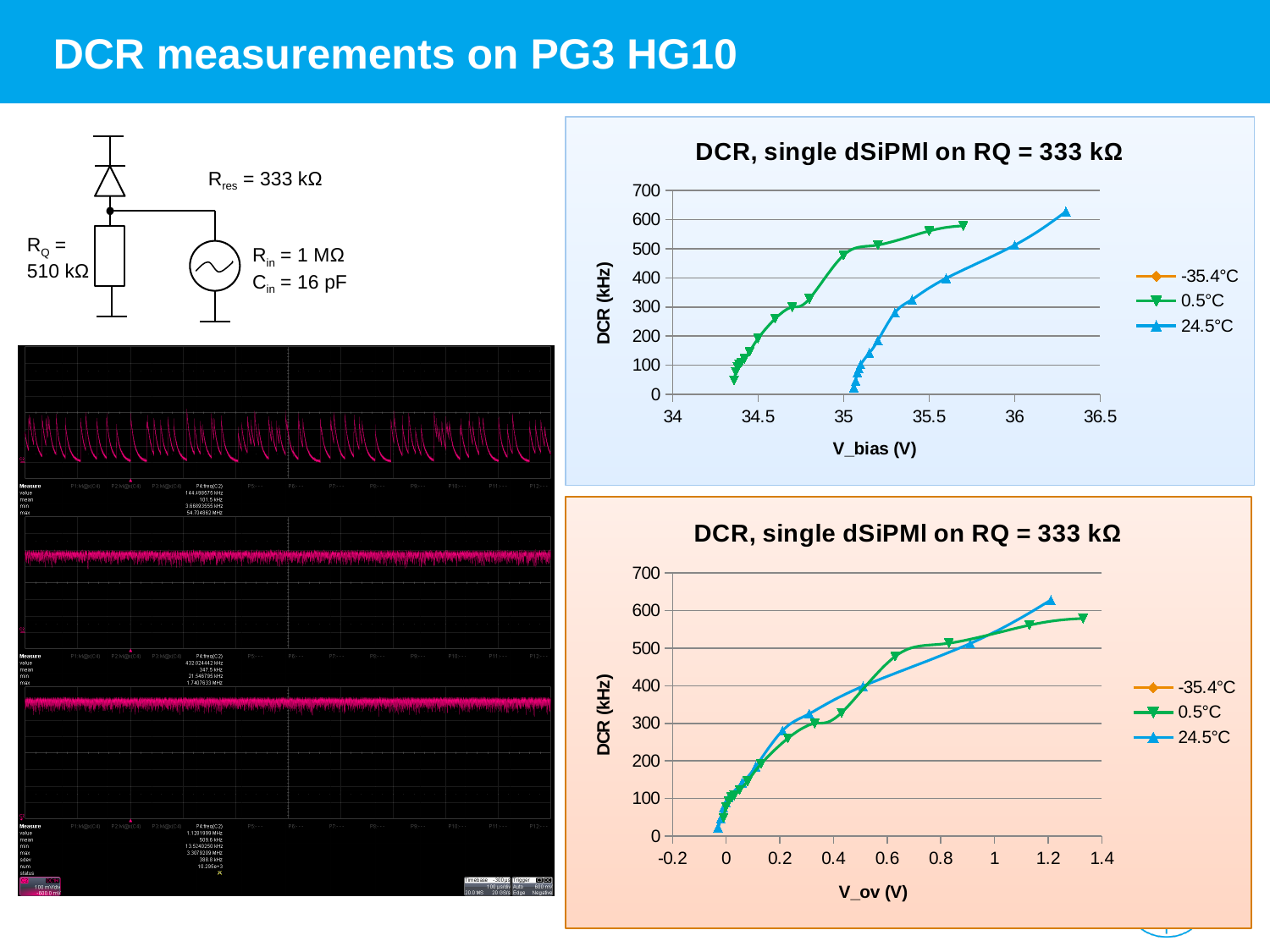
In the bottom-right chart, is the DCR for the 0.5°C series at V_ov = 0.2 V greater or less than 300 kHz? less How many series does the legend of the bottom-right chart list? 3 In the top-right chart, does the DCR rise or fall as V_bias increases? rise What kind of chart is the top-right chart on the slide? line chart In the top-right chart, at V_bias = 35.5 V, which series has the higher DCR: 0.5°C or 24.5°C? 0.5°C In the bottom-right chart, at V_ov = 1.2 V, which series has the higher DCR: 0.5°C or 24.5°C? 24.5°C In the bottom-right chart, is the DCR for the 24.5°C series at V_ov = 1.2 V greater or less than 600 kHz? greater What is the y-axis label of the top-right chart? DCR (kHz) What is the x-axis label of the bottom-right chart? V_ov (V) In the top-right chart, is the DCR for the 0.5°C series at V_bias = 35.5 V greater or less than 500 kHz? greater How many series does the legend of the top-right chart list? 3